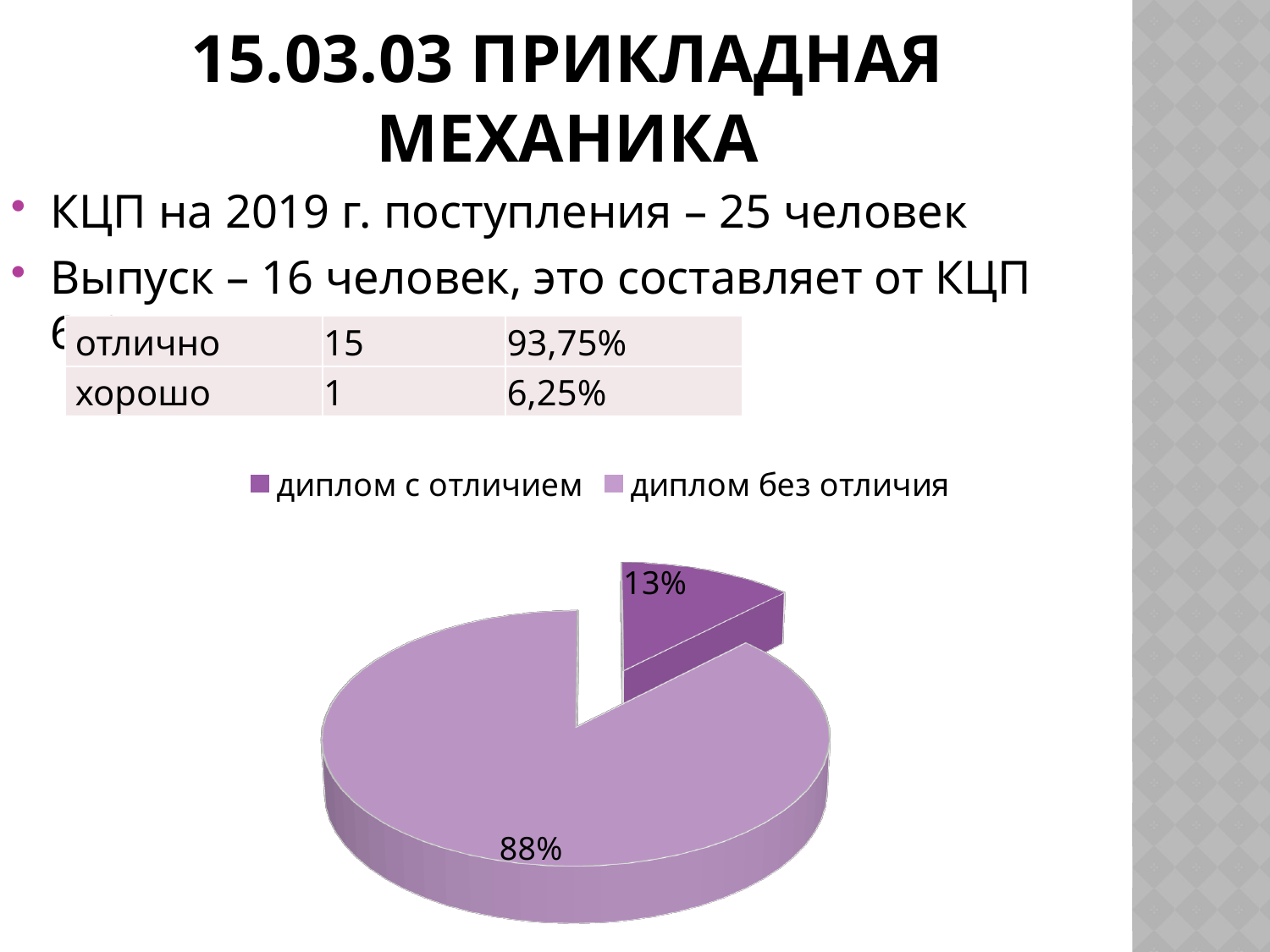
What is the difference in percentage points between the 'диплом без отличия' slice and the 'диплом с отличием' slice? 75% What share of the pie is labelled 'диплом с отличием'? 13% How many entries does the legend list? 2 Where is the legend positioned relative to the pie? above the pie What share of the pie is labelled 'диплом без отличия'? 88% How many slices does the pie chart have? 2 Is the share for 'диплом с отличием' greater or less than 50%? less Which legend entry is shown in the darker purple colour? диплом с отличием Which is larger: the share for 'диплом с отличием' or the share for 'диплом без отличия'? диплом без отличия What kind of chart is shown on the slide? pie chart Which slice of the pie is the smallest? диплом с отличием Which slice of the pie is the largest? диплом без отличия